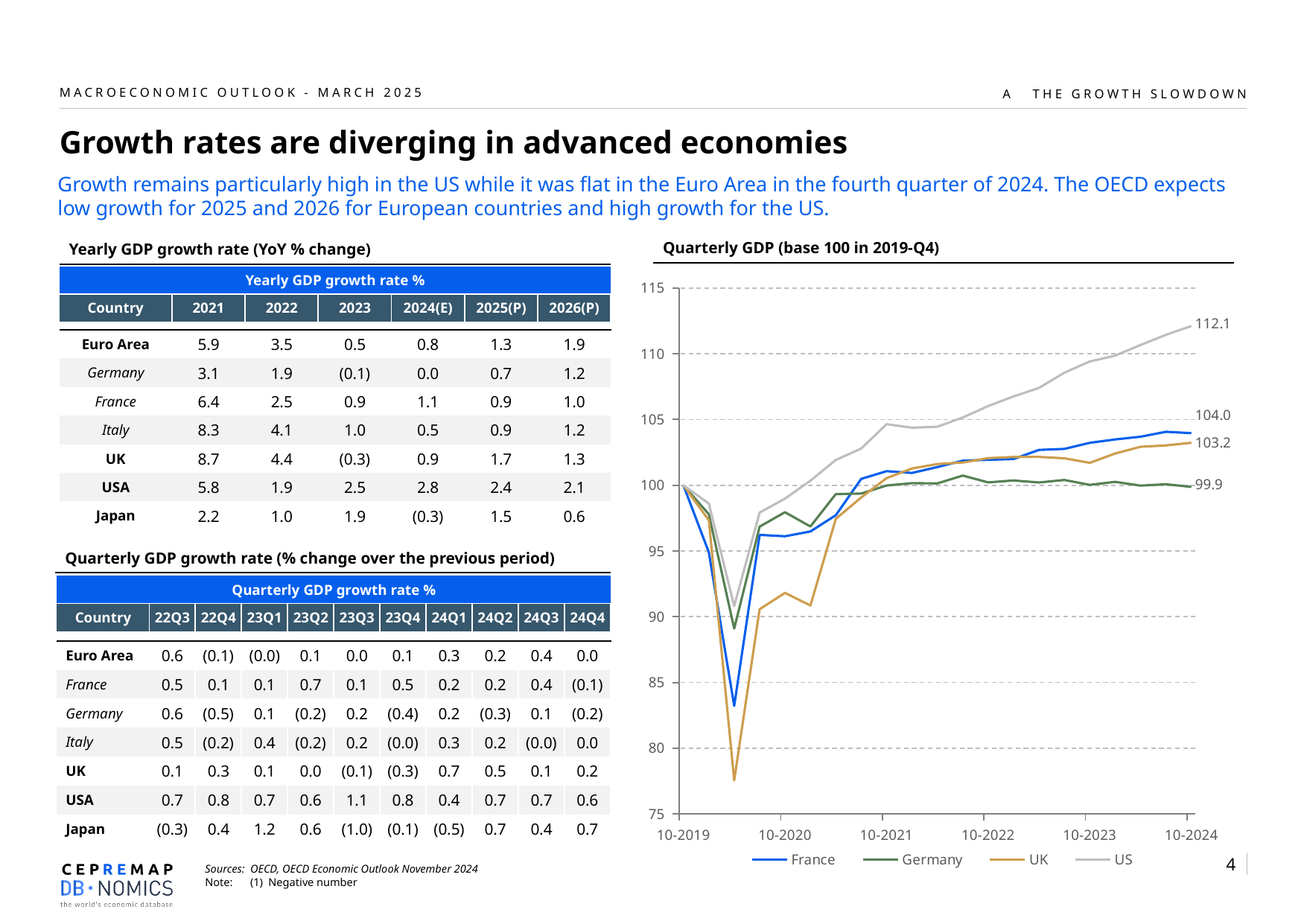
In the Quarterly GDP chart, what is the final labelled value for the US? 112.1 In the Quarterly GDP chart, which is larger at the end of the series, France or the UK? France In the Quarterly GDP chart, what is the final labelled value for Germany? 99.9 In the Quarterly GDP chart, is the value for the US at 10-2023 greater or less than 105? greater In the Quarterly GDP chart, what is the final labelled value for France? 104.0 How many series does the legend of the Quarterly GDP chart list? 4 In the Quarterly GDP chart, what is the difference between the final values of the US and Germany? 12.2 What kind of chart is the "Quarterly GDP (base 100 in 2019-Q4)" chart? line chart In the Quarterly GDP chart, what is the final labelled value for the UK? 103.2 In the Quarterly GDP chart, which country has the highest value at the end of the series? US In the Quarterly GDP chart, which country has the lowest value at the end of the series? Germany In the Quarterly GDP chart, does the US line rise or fall between 10-2021 and 10-2024? rise